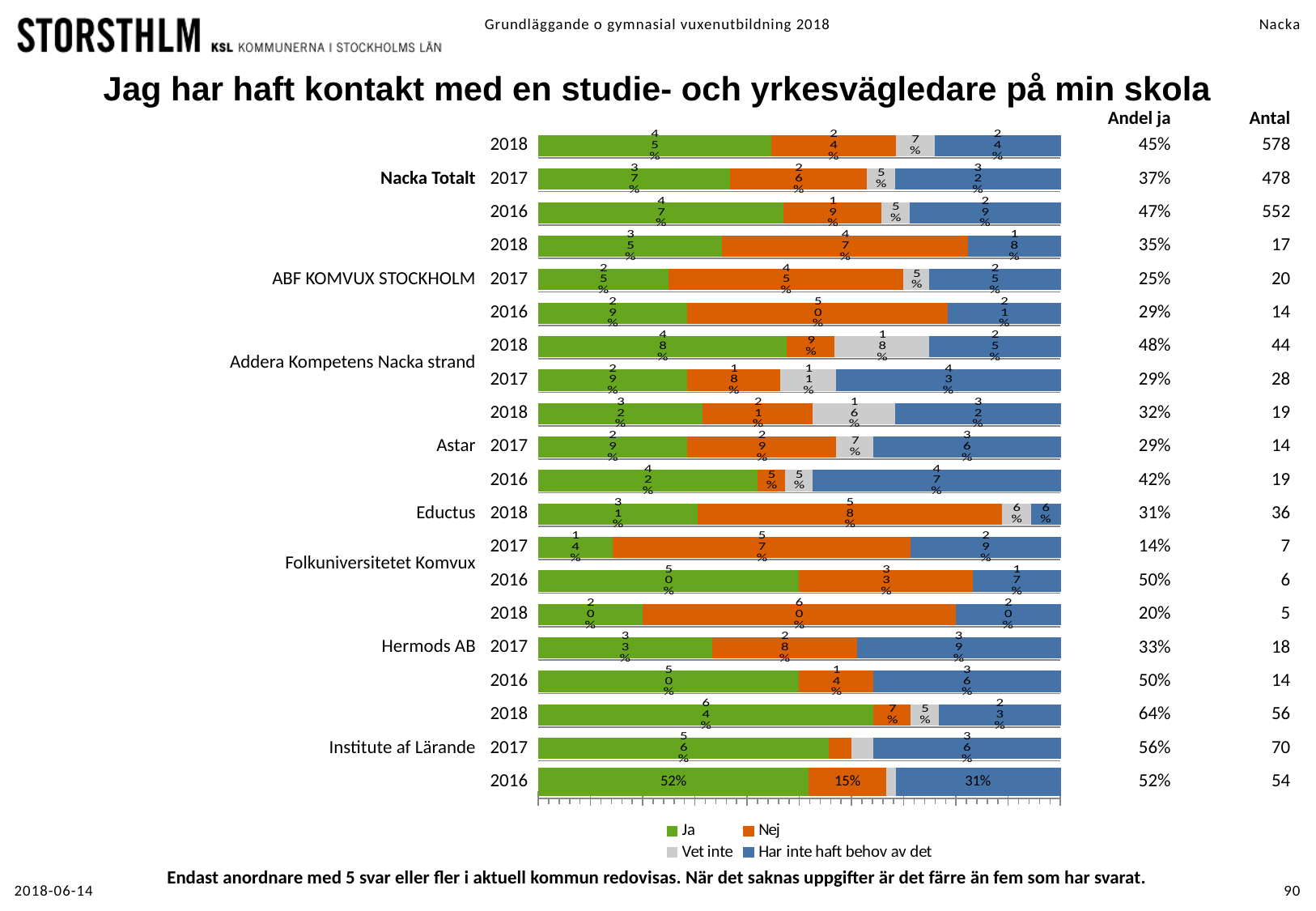
What is the 'Nej' share for Eductus in 2018? 58% How many series does the legend list? 4 Which legend entry is shown in blue? Har inte haft behov av det What is the 'Har inte haft behov av det' share for Addera Kompetens Nacka strand in 2017? 43% Which provider-year bar has the highest 'Ja' share? Institute af Lärande 2018 Which is larger: the 'Nej' share for Hermods AB in 2018 or for Hermods AB in 2017? Hermods AB 2018 What kind of chart is shown on the slide? Stacked bar chart Which provider-year bar has the lowest 'Ja' share? Folkuniversitetet Komvux 2017 What is the 'Antal' value for Nacka Totalt in 2018? 578 What is the 'Ja' share for Nacka Totalt in 2018? 45% What is the difference between the 'Ja' share for Nacka Totalt in 2018 and in 2017? 8 percentage points What is the 'Vet inte' share for Astar in 2018? 16%